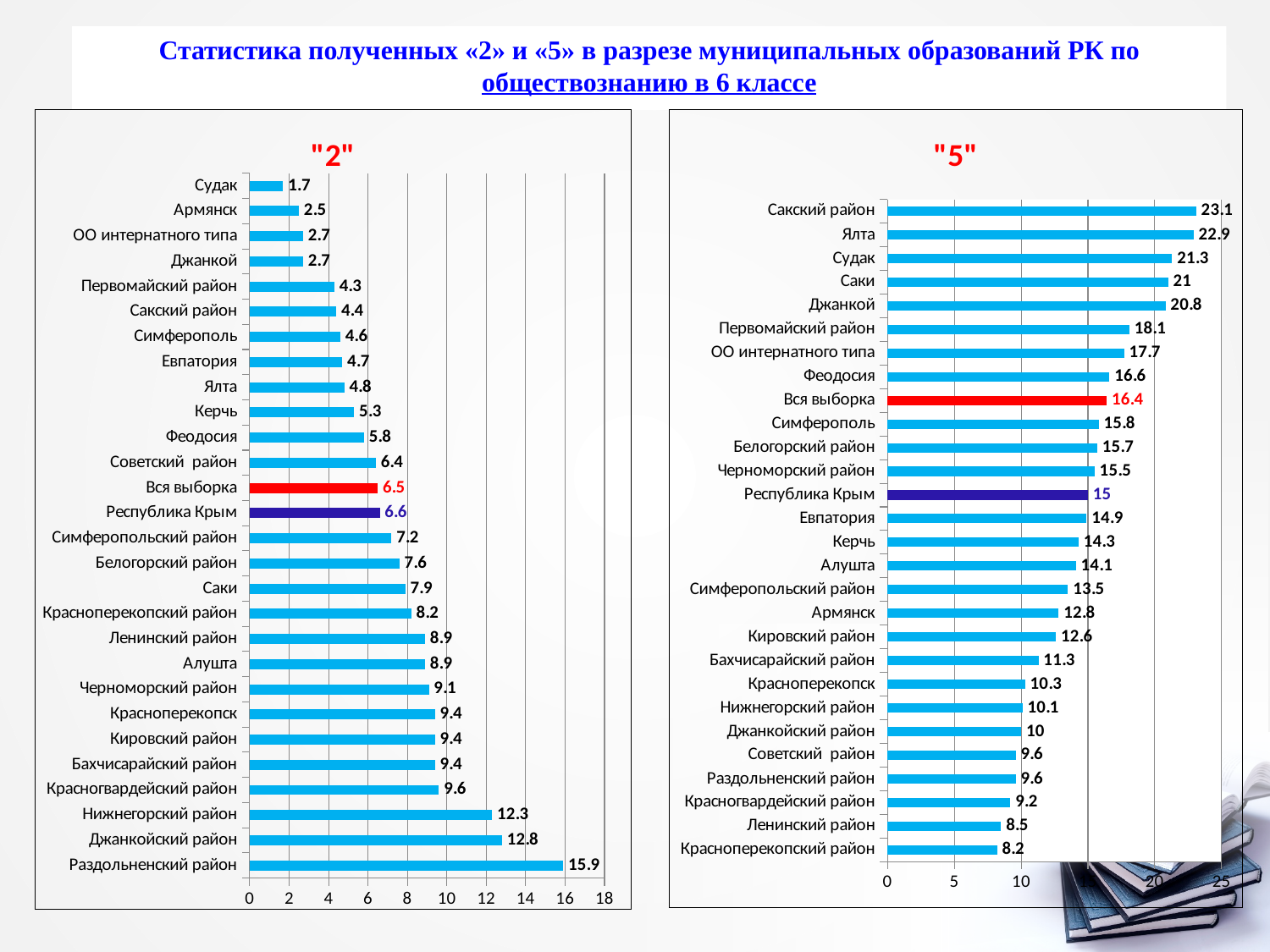
In the "5" chart, which category has the highest value? Сакский район In the "2" chart, what is the difference between the values for Джанкойский район and Нижнегорский район? 0.5 In the "2" chart, what colour is the bar for Вся выборка? red In the "2" chart, what is the value for Раздольненский район? 15.9 In the "5" chart, what is the value for Вся выборка? 16.4 In the "5" chart, which category has the lowest value? Красноперекопский район What kind of chart is the "5" chart? bar chart In the "5" chart, is the value for Ялта greater or less than 20? greater In the "5" chart, what is the difference between the values for Сакский район and Республика Крым? 8.1 In the "2" chart, which category has the lowest value? Судак In the "2" chart, which is larger: the value for Керчь or the value for Феодосия? Феодосия How many categories are shown in the "2" chart? 28